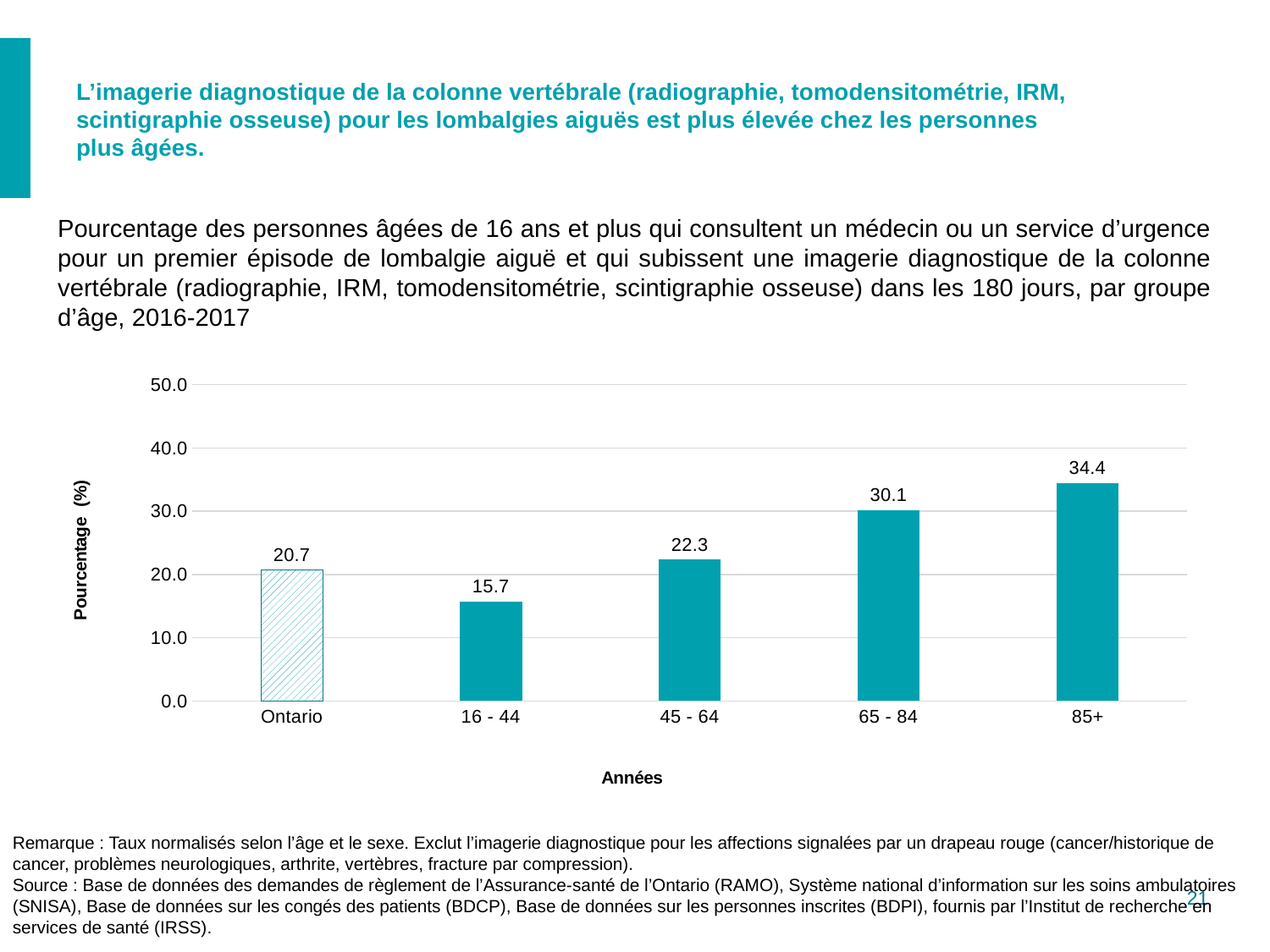
Do the values rise or fall across the age groups from 16 - 44 to 85+? rise Which is larger, the value for Ontario or the value for 45 - 64? 45 - 64 What is the value for the 85+ age group? 34.4 Is the value for 65 - 84 greater or less than 30.0? greater What is the value for Ontario? 20.7 What is the difference between the values for 85+ and 16 - 44? 18.7 Which category has the lowest value? 16 - 44 How many categories are shown on the x axis? 5 What is the difference between the values for 65 - 84 and 45 - 64? 7.8 Which category has the highest value? 85+ What is the value for the 16 - 44 age group? 15.7 What kind of chart is shown on the slide? bar chart